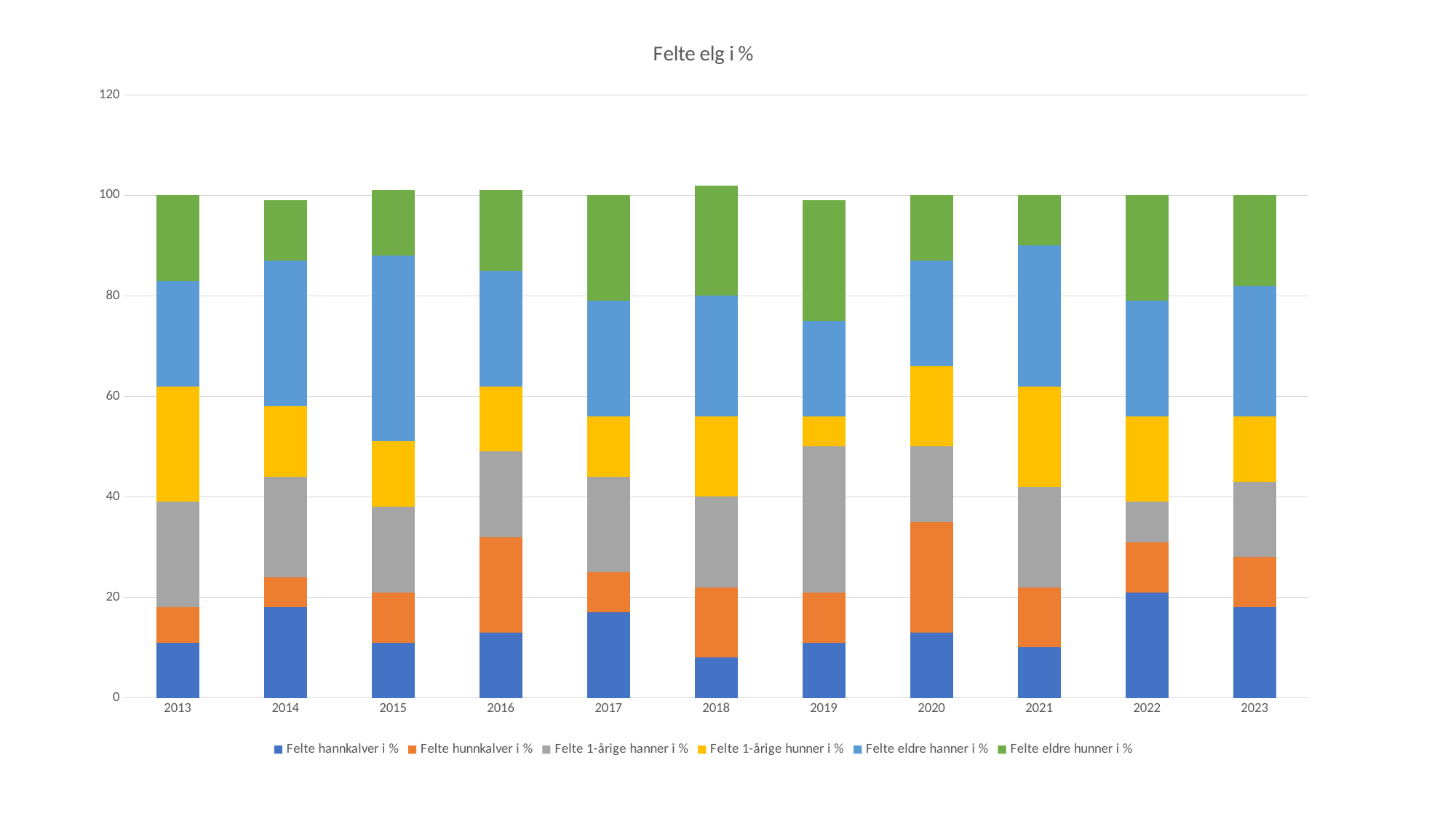
In which year is the value for Felte eldre hanner i % the highest? 2015 What is the title of the chart? Felte elg i % Is the value for Felte hannkalver i % in 2018 greater or less than 20? less Which colour represents Felte 1-årige hunner i % in the chart? Yellow What kind of chart is shown on the slide? Stacked bar chart Is the value for Felte eldre hanner i % in 2015 greater or less than 20? greater Which year has the larger value for Felte hunnkalver i %, 2013 or 2020? 2020 How many series does the legend of the chart list? 6 Which year has the larger value for Felte 1-årige hanner i %, 2019 or 2022? 2019 Which year has the larger value for Felte eldre hunner i %, 2015 or 2019? 2019 How many years are shown along the x axis of the chart? 11